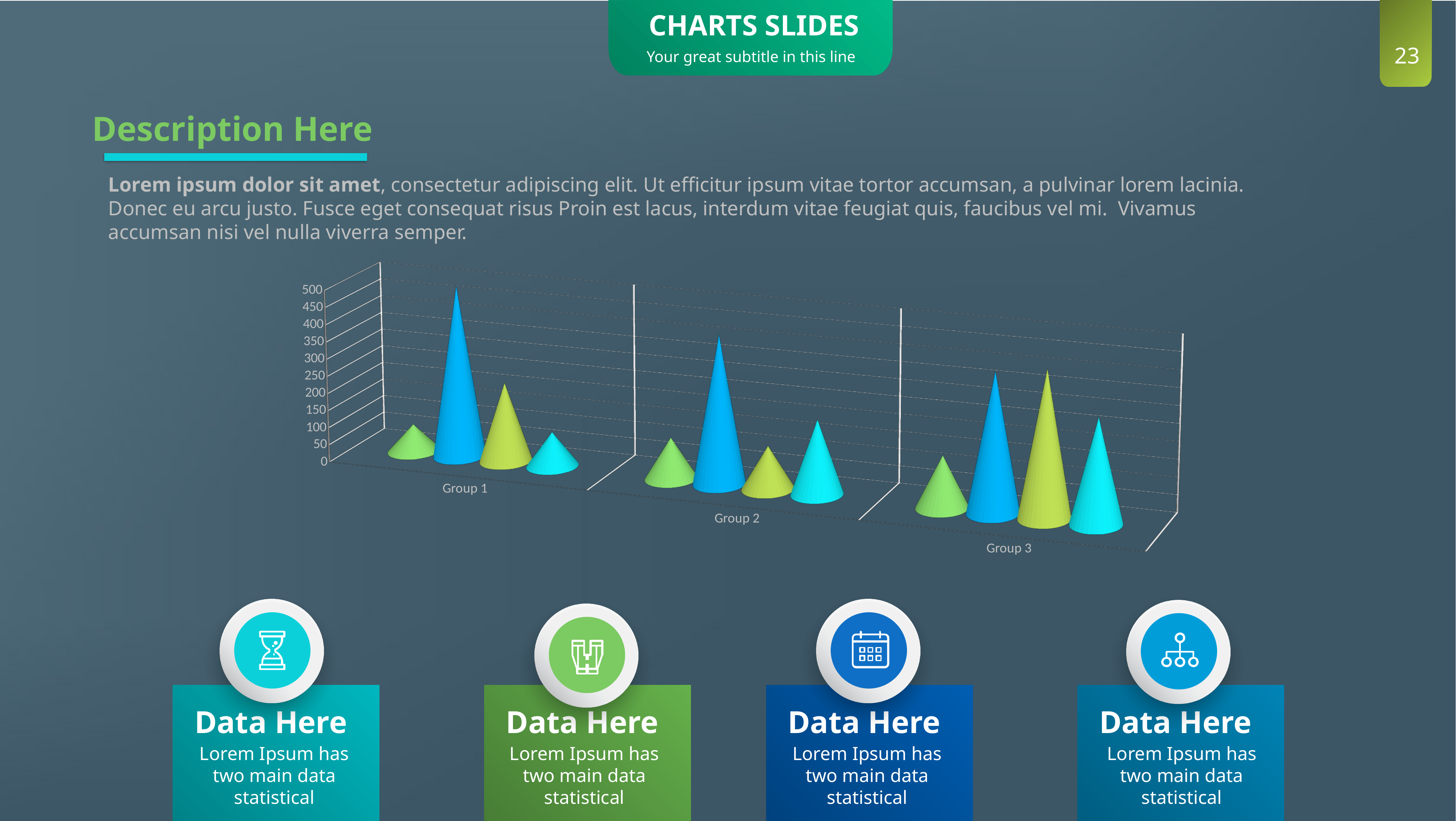
Which is larger in Group 2, the blue cone or the yellow-green cone? the blue cone What is the highest value shown on the chart's vertical axis? 500 Is the value of the green cone in Group 1 greater or less than 200? less How many cones are plotted for each group on the chart? 4 In which group is the blue cone the tallest? Group 1 How many groups (categories) are shown on the chart's x axis? 3 What is the label of the middle category on the chart's x axis? Group 2 Which cone is the tallest in Group 1? the blue cone Which cone is the shortest in Group 1? the green cone What kind of chart is shown on the slide? bar chart Which cone is the shortest in Group 3? the green cone Is the value of the blue cone in Group 1 greater or less than 400? greater